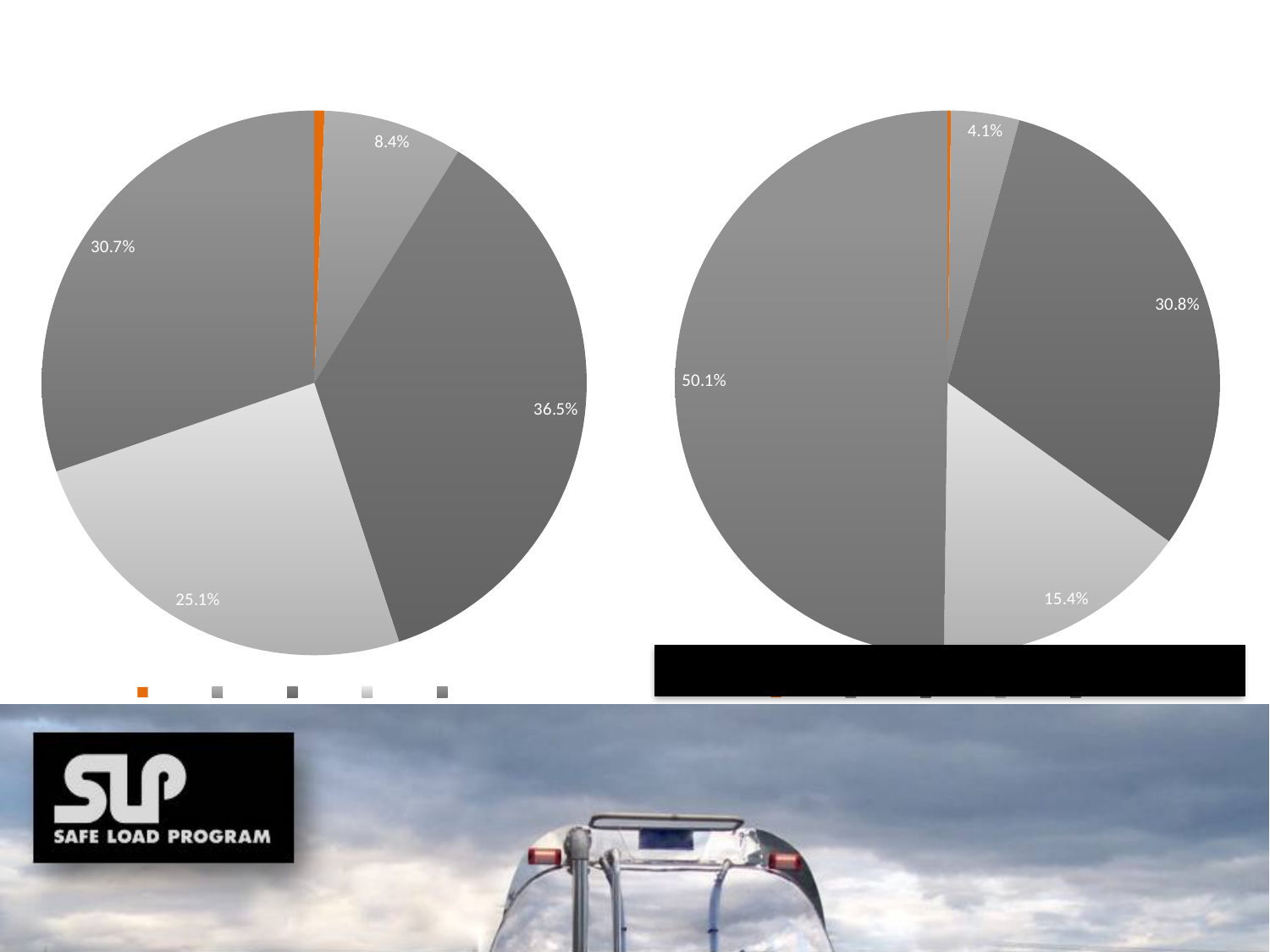
In the pie chart on the right, what is the difference between the 50.1% slice and the 30.8% slice? 19.3% In the pie chart on the left, what is the value of the largest slice? 36.5% How many slices does the pie chart on the left have? 5 In the pie chart on the right, what is the value of the largest slice? 50.1% In the pie chart on the right, which is larger, the slice labelled 30.8% or the slice labelled 15.4%? 30.8% What kind of chart is the chart on the left of the slide? pie chart In the pie chart on the right, what is the smallest labelled slice value? 4.1% In the pie chart on the right, does the largest slice account for more or less than half of the pie? more What kind of chart is the chart on the right of the slide? pie chart How many entries does the legend below the pie chart on the left show? 5 In the pie chart on the left, what is the difference between the 36.5% slice and the 25.1% slice? 11.4% In the pie chart on the left, what is the smallest labelled slice value? 8.4%